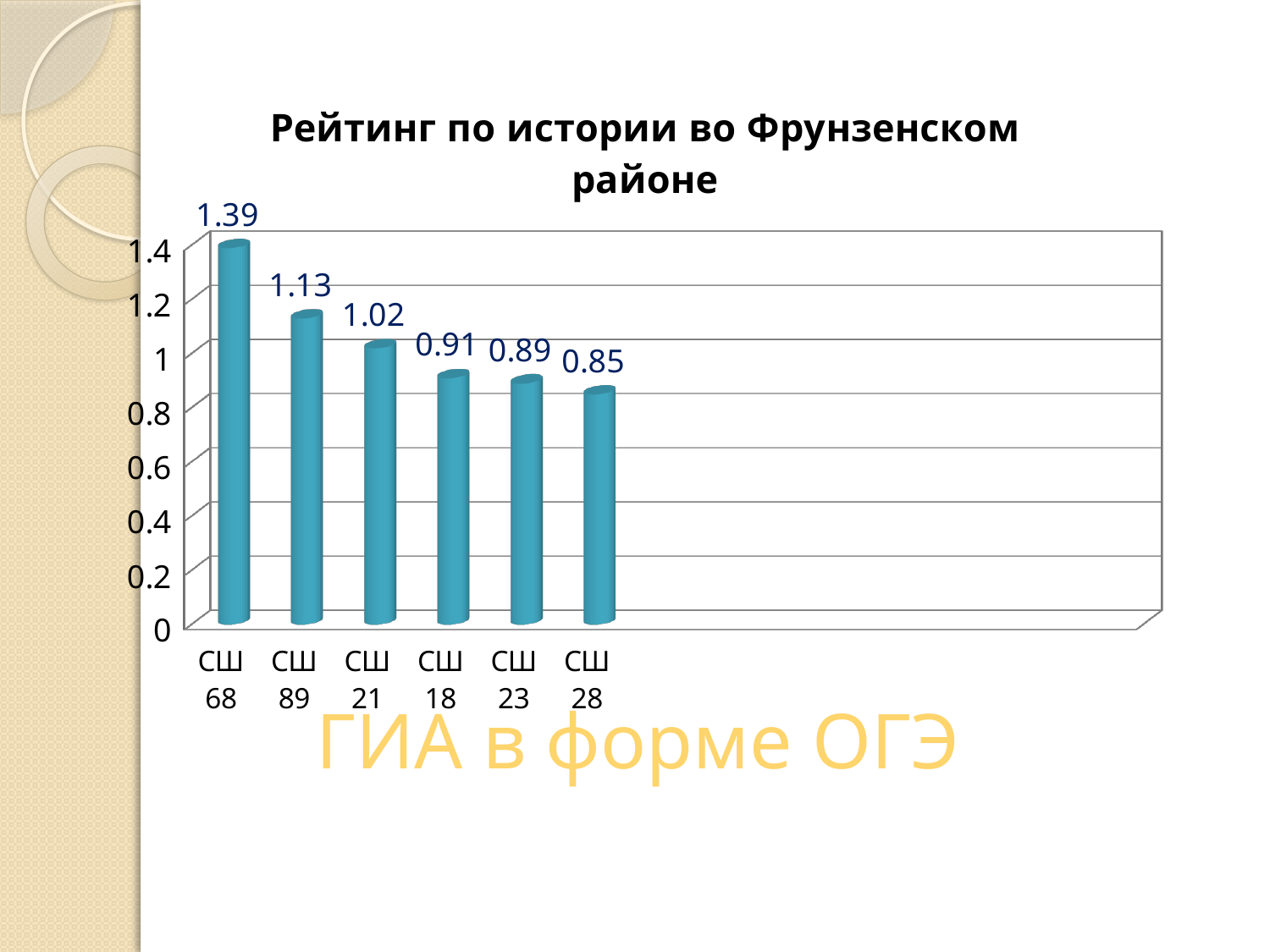
Which school has the lowest value? СШ 28 How many schools are shown on the chart? 6 What is the value for СШ 28? 0.85 Is the value for СШ 21 greater or less than 0.8? greater What is the difference between the values for СШ 68 and СШ 89? 0.26 Which school has the highest value? СШ 68 What is the value for СШ 18? 0.91 Do the values rise or fall from left to right along the x axis? fall What is the difference between the values for СШ 21 and СШ 28? 0.17 What kind of chart is shown on the slide? bar chart What is the value for СШ 68? 1.39 Which is larger, the value for СШ 89 or the value for СШ 23? СШ 89